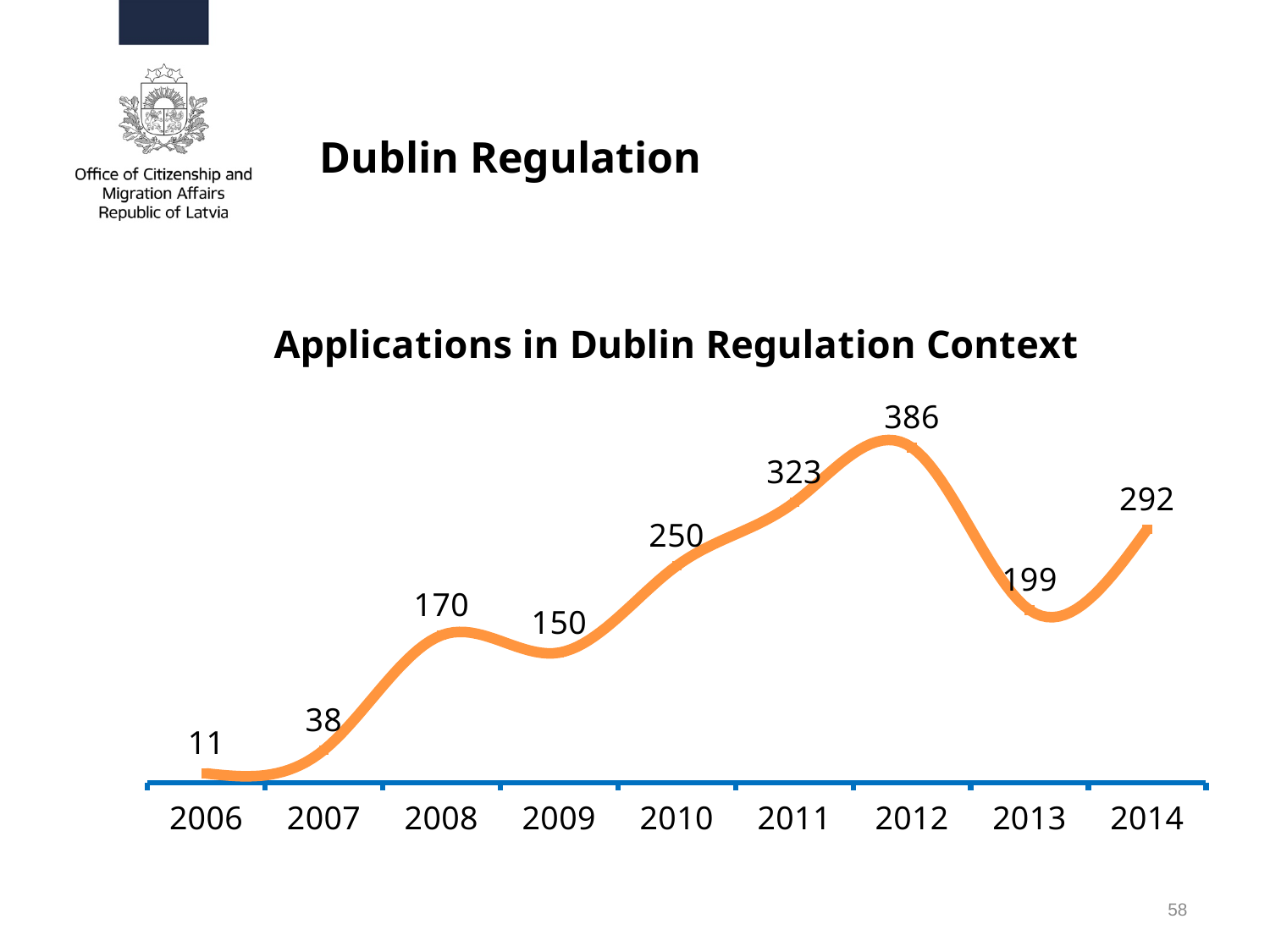
What is the difference between the values for 2008 and 2007? 132 What is the value for 2014? 292 What is the title of the chart? Applications in Dublin Regulation Context What kind of chart is shown? line chart What is the value for 2006? 11 Which year has the lowest value? 2006 What is the value for 2009? 150 What is the value for 2012? 386 Which is larger, the value for 2011 or the value for 2014? 2011 What is the difference between the values for 2012 and 2013? 187 How many years are plotted on the chart? 9 Which year has the highest value? 2012